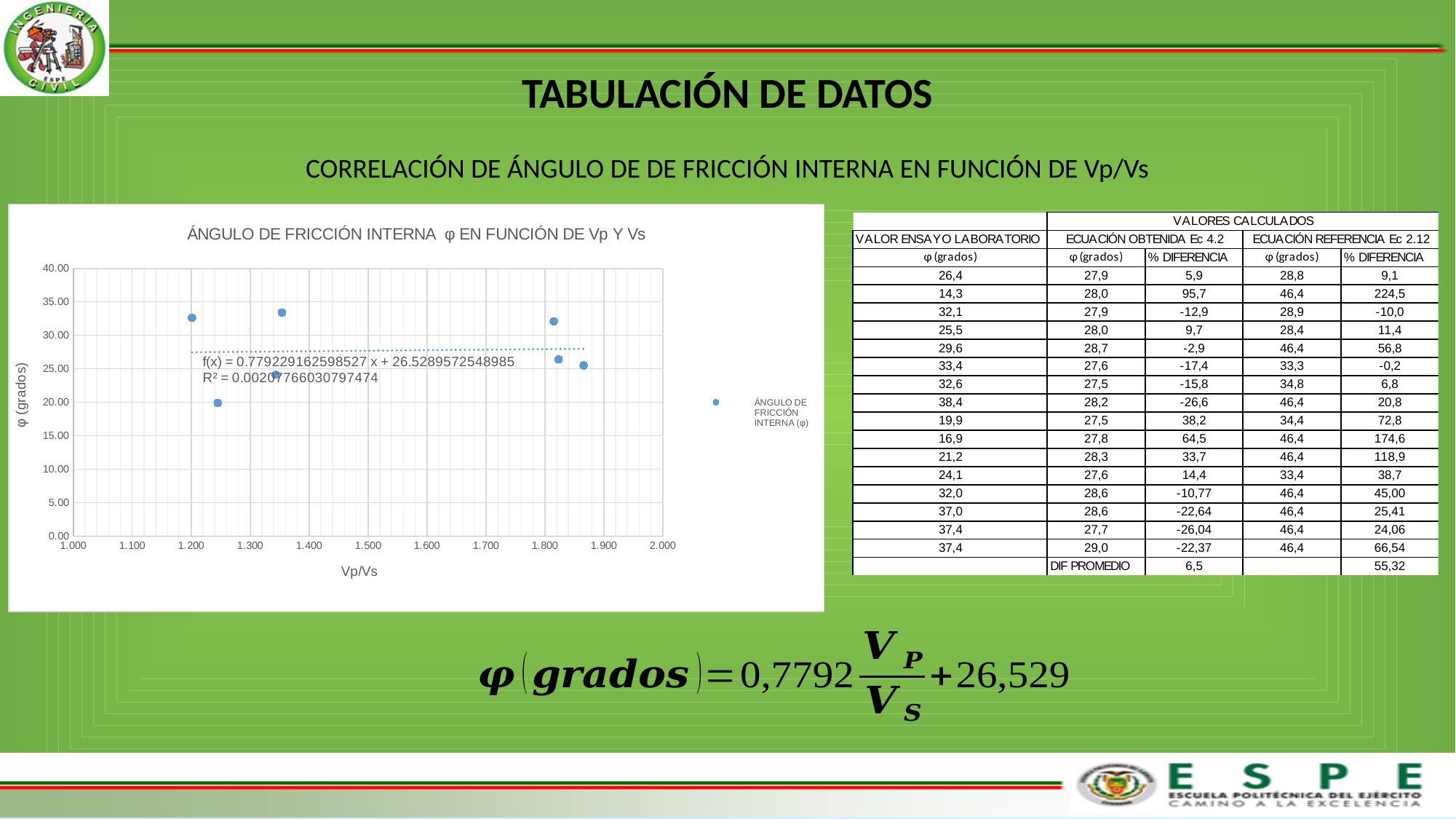
Which is larger: the value of the point at Vp/Vs ≈ 1.200 or the value of the point at Vp/Vs ≈ 1.245? The point at Vp/Vs ≈ 1.200 What is the label on the x axis of the chart? Vp/Vs What R² value is printed on the chart? R² = 0.00207766030797474 What is the maximum value shown on the y axis of the chart? 40.00 Does the fitted trendline rise or fall as Vp/Vs increases? Rises What is the title of the chart? ÁNGULO DE FRICCIÓN INTERNA φ EN FUNCIÓN DE Vp Y Vs Is the value of the point at Vp/Vs ≈ 1.200 greater or less than 30.00? greater Is the value of the lowest point on the chart greater or less than 25.00? less What kind of chart is shown on the slide? Scatter chart What trendline equation is printed on the chart? f(x) = 0.779229162598527 x + 26.5289572548985 How many series does the chart legend list? 1